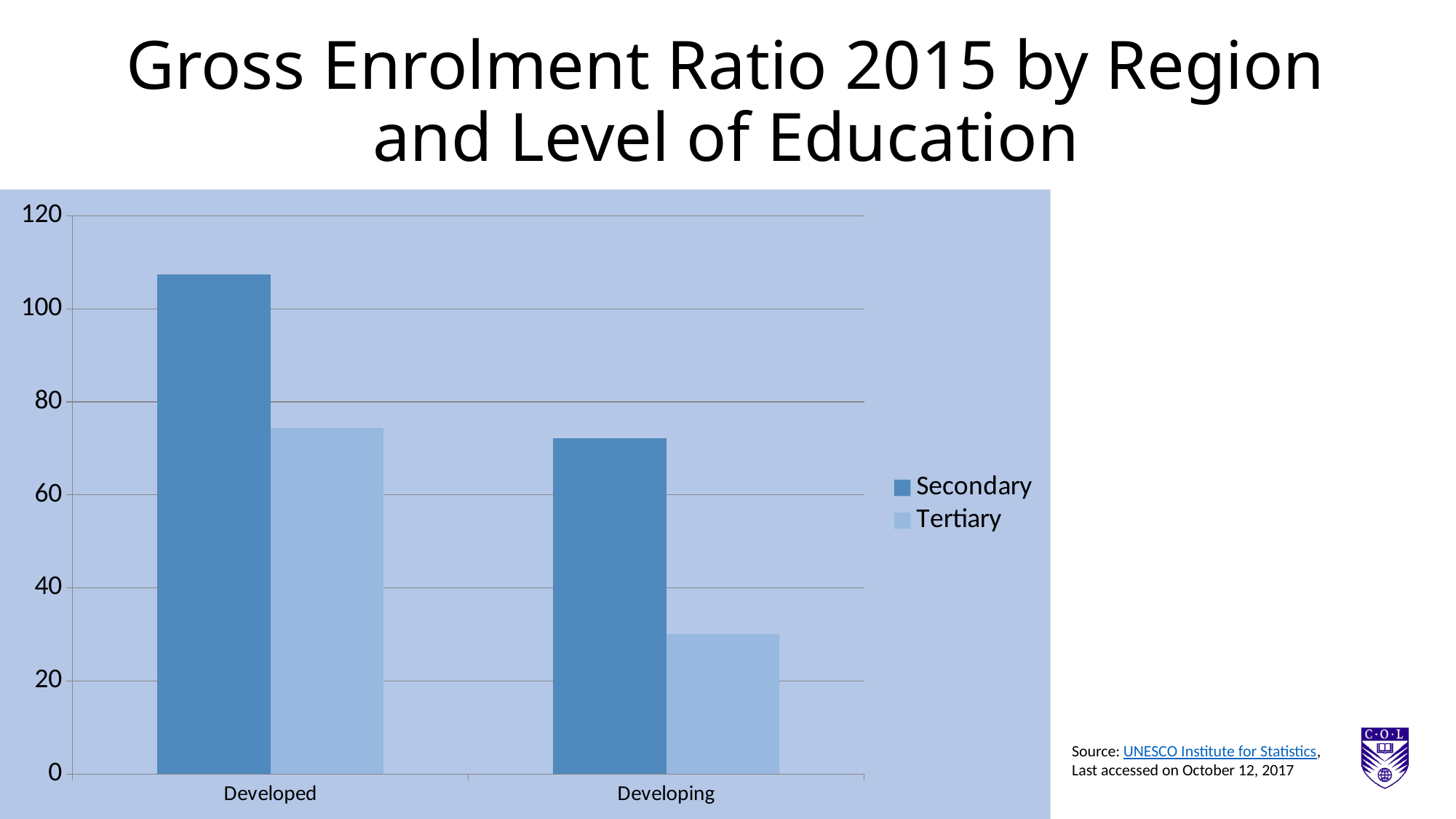
Is the Secondary value for Developing greater or less than 80? less What is the title of the slide containing the chart? Gross Enrolment Ratio 2015 by Region and Level of Education Which is larger, the Tertiary value for Developed or the Tertiary value for Developing? Developed Which region has the lowest Tertiary gross enrolment ratio? Developing How many region categories are shown on the x axis? 2 Which region has the highest Secondary gross enrolment ratio? Developed How many series does the legend list? 2 Is the Secondary value for Developed greater or less than 100? greater Is the Tertiary value for Developed greater or less than 80? less What kind of chart is shown on the slide? bar chart Which is larger for the Developing region, the Secondary value or the Tertiary value? Secondary